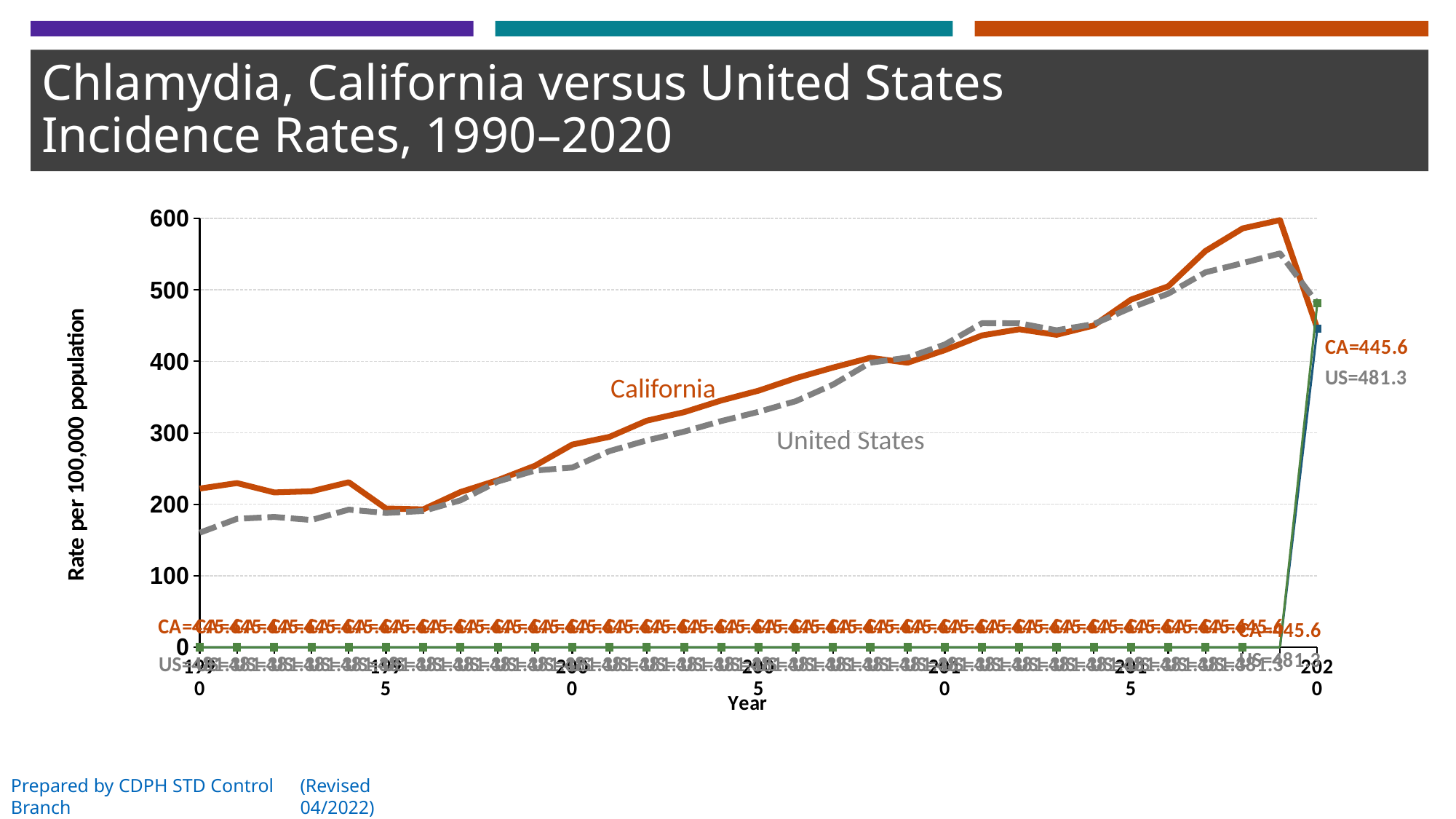
In 2019, which line is higher, California or the United States? California What is the label on the vertical axis of the chart? Rate per 100,000 population Overall, do the California and United States rates rise or fall from 1990 to 2019? Rise What is the United States chlamydia incidence rate shown for 2020? 481.3 What is the difference between the United States rate (481.3) and the California rate (445.6) in 2020? 35.7 What is the title of the slide? Chlamydia, California versus United States Incidence Rates, 1990–2020 What kind of chart is shown on the slide? Line chart In 2020, which has the higher rate, California or the United States? United States Is the California rate in 1990 greater or less than 200? greater Is the United States rate in 2019 greater or less than 500? greater Is the United States rate in 1990 greater or less than 200? less What is the California chlamydia incidence rate shown for 2020? 445.6